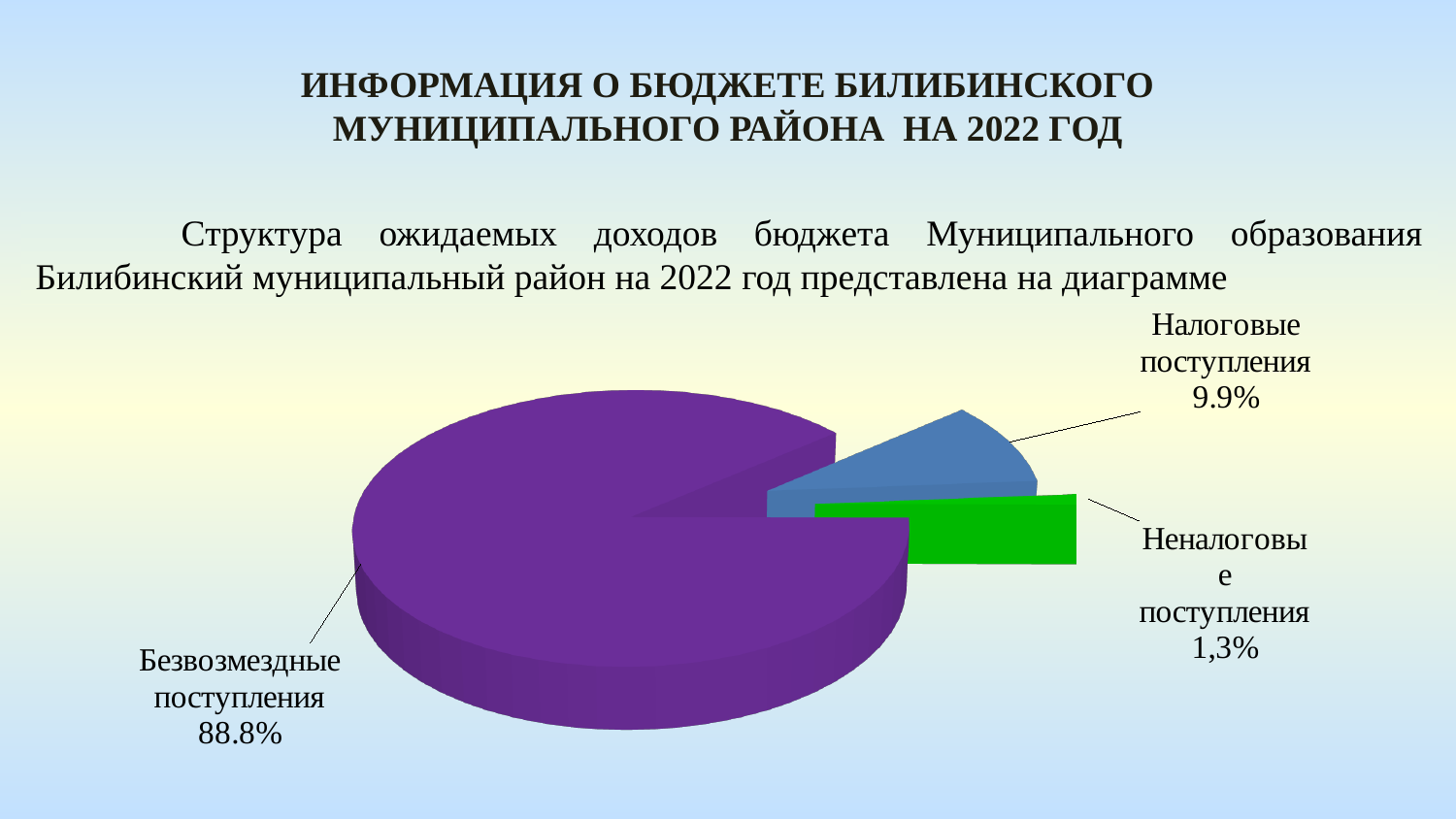
What is the difference in percentage points between Налоговые поступления and Неналоговые поступления? 8.6 Which category has the smallest slice of the pie? Неналоговые поступления How many slices does the pie chart have? 3 Which is larger: the slice for Налоговые поступления or the slice for Неналоговые поступления? Налоговые поступления What share of the pie is labelled for Безвозмездные поступления? 88.8% What colour is the slice for Безвозмездные поступления? purple What share of the pie is labelled for Налоговые поступления? 9.9% Which category has the largest slice of the pie? Безвозмездные поступления What share of the pie is labelled for Неналоговые поступления? 1,3% What is the difference in percentage points between Безвозмездные поступления and Налоговые поступления? 78.9 What kind of chart is shown on the slide? pie chart What colour is the slice for Неналоговые поступления? green